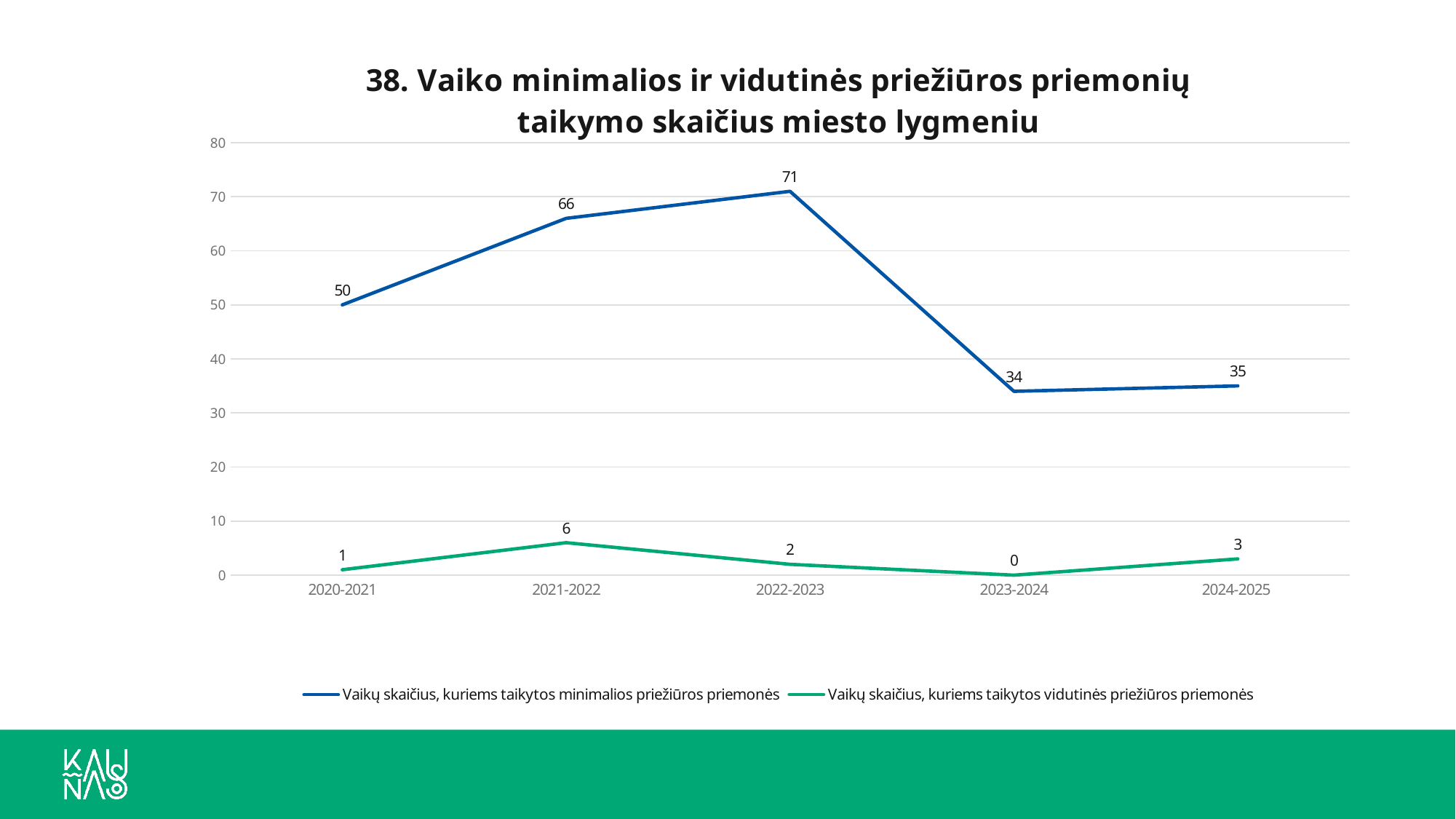
How many periods are shown on the x axis? 5 Does 'Vaikų skaičius, kuriems taikytos minimalios priežiūros priemonės' rise or fall from 2022-2023 to 2023-2024? Fall What is the difference between the 'minimalios priežiūros priemonės' values for 2022-2023 and 2023-2024? 37 What is the value for 'Vaikų skaičius, kuriems taikytos minimalios priežiūros priemonės' in 2020-2021? 50 In which period is 'Vaikų skaičius, kuriems taikytos minimalios priežiūros priemonės' highest? 2022-2023 What is the value for 'Vaikų skaičius, kuriems taikytos vidutinės priežiūros priemonės' in 2021-2022? 6 What kind of chart is shown on the slide? Line chart What is the value for 'Vaikų skaičius, kuriems taikytos minimalios priežiūros priemonės' in 2022-2023? 71 In which period is 'Vaikų skaičius, kuriems taikytos vidutinės priežiūros priemonės' lowest? 2023-2024 What colour is the line for 'Vaikų skaičius, kuriems taikytos vidutinės priežiūros priemonės'? Green How many series does the legend list? 2 Which is larger: the 'minimalios priežiūros priemonės' value in 2021-2022 or in 2024-2025? 2021-2022